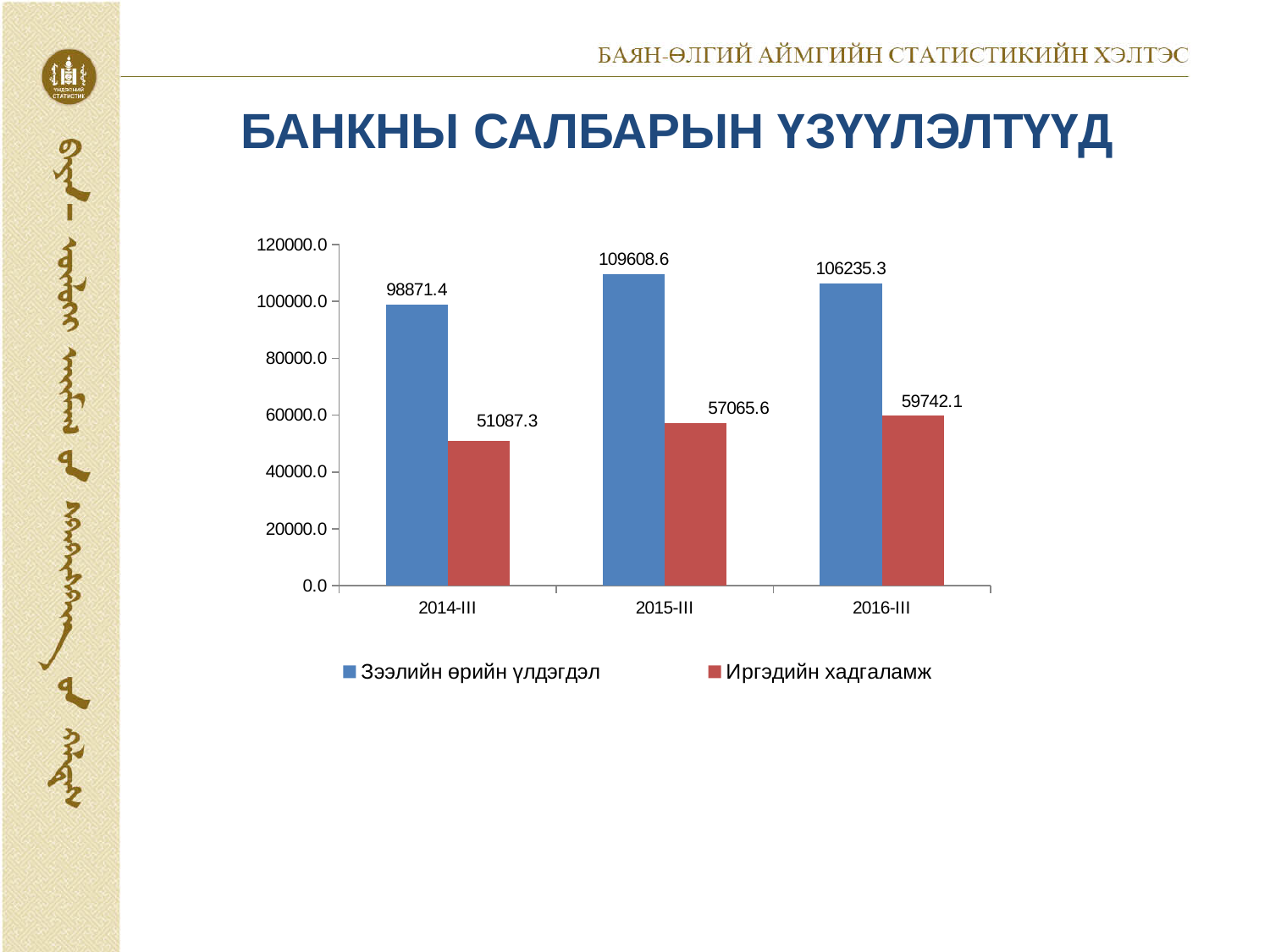
Which is larger in 2016-III: Зээлийн өрийн үлдэгдэл or Иргэдийн хадгаламж? Зээлийн өрийн үлдэгдэл How many series does the legend list? 2 In which period is Иргэдийн хадгаламж lowest? 2014-III What is the value of Зээлийн өрийн үлдэгдэл for 2014-III? 98871.4 In which period is Зээлийн өрийн үлдэгдэл highest? 2015-III How many periods are shown on the x axis? 3 By how much did Зээлийн өрийн үлдэгдэл change from 2014-III to 2015-III? 10737.2 What is the value of Иргэдийн хадгаламж for 2016-III? 59742.1 Is the value of Зээлийн өрийн үлдэгдэл for 2014-III greater or less than 100000.0? less Does Иргэдийн хадгаламж rise or fall from 2014-III to 2016-III? rise What is the difference between Зээлийн өрийн үлдэгдэл and Иргэдийн хадгаламж in 2015-III? 52543.0 What is the value of Иргэдийн хадгаламж for 2015-III? 57065.6